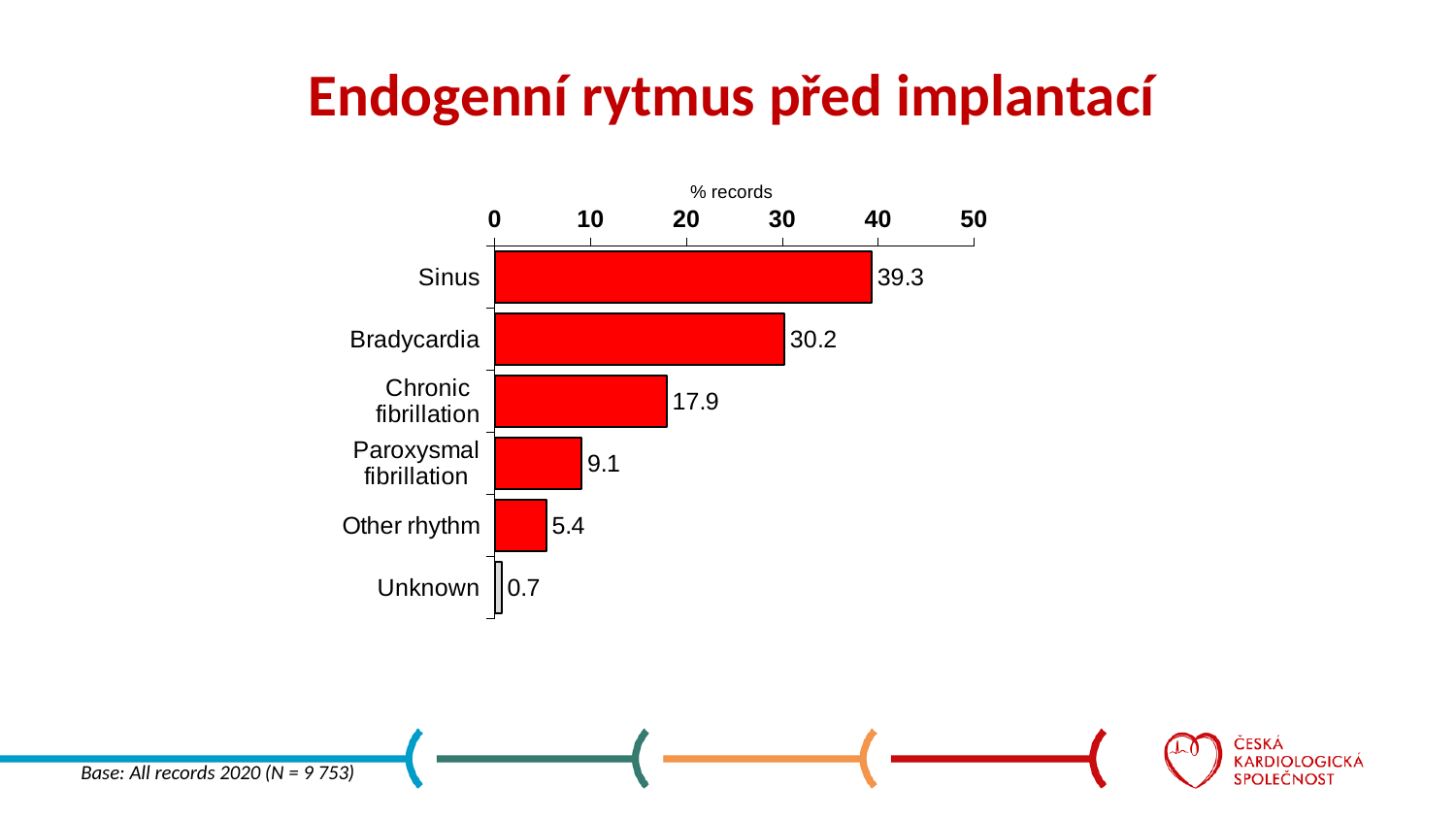
What is the value for Sinus? 39.3 Which is larger, the value for Chronic fibrillation or the value for Paroxysmal fibrillation? Chronic fibrillation How many categories are shown in the chart? 6 What is the value for Paroxysmal fibrillation? 9.1 What kind of chart is shown on the slide? Bar chart What is the difference between the values for Sinus and Bradycardia? 9.1 Which category has the highest value? Sinus Which category has the lowest value? Unknown What is the value for Chronic fibrillation? 17.9 What is the value for Unknown? 0.7 What is the value for Bradycardia? 30.2 What is the label of the value axis? % records